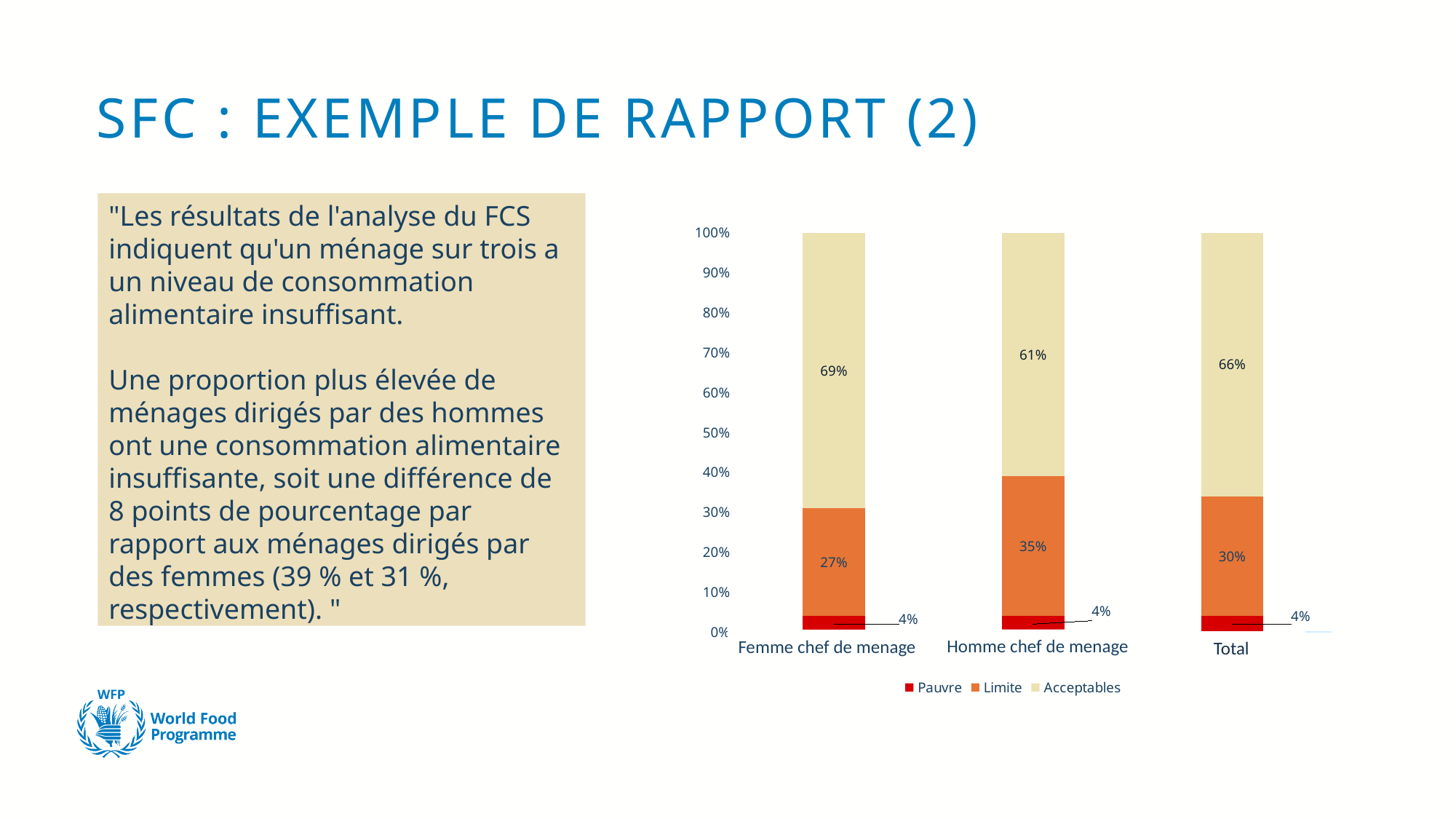
What is the value of the Acceptables series for Femme chef de menage? 69% How many series does the legend list? 3 How many categories are shown on the x axis? 3 What is the value of the Limite series for Total? 30% Which category has the highest Acceptables value? Femme chef de menage Which category has the lowest Limite value? Femme chef de menage Which is larger, the Acceptables value for Homme chef de menage or for Total? Total What kind of chart is shown on the slide? Stacked bar chart Which series is shown in red in the legend? Pauvre What is the value of the Limite series for Homme chef de menage? 35% What is the value of the Pauvre series for Total? 4% What is the difference between the Limite values for Homme chef de menage and Femme chef de menage? 8%